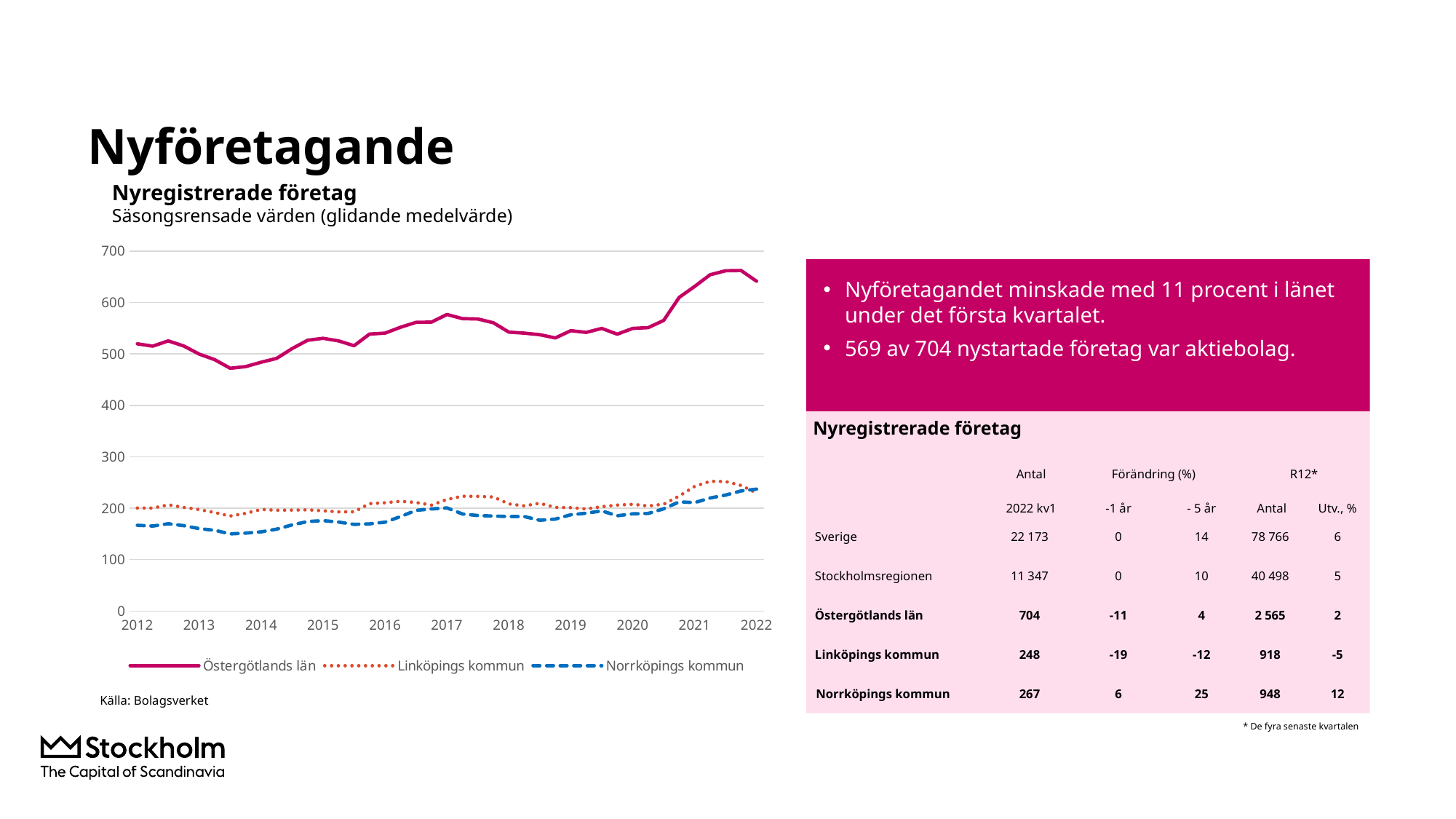
Does the Östergötlands län line rise or fall between 2020 and 2021? rise Which series are listed in the chart legend? Östergötlands län, Linköpings kommun, Norrköpings kommun Is the value for Norrköpings kommun at 2022 greater or less than 200? greater Which series has the lowest value at the start of 2012? Norrköpings kommun How many series does the chart legend list? 3 Is the value for Östergötlands län at 2012 greater or less than 500? greater Which series has the highest values throughout the chart? Östergötlands län Is the value for Norrköpings kommun at 2012 greater or less than 200? less What kind of chart is shown on the slide? line chart What is the title of the chart? Nyregistrerade företag At 2022, which is larger: the value for Östergötlands län or the value for Norrköpings kommun? Östergötlands län